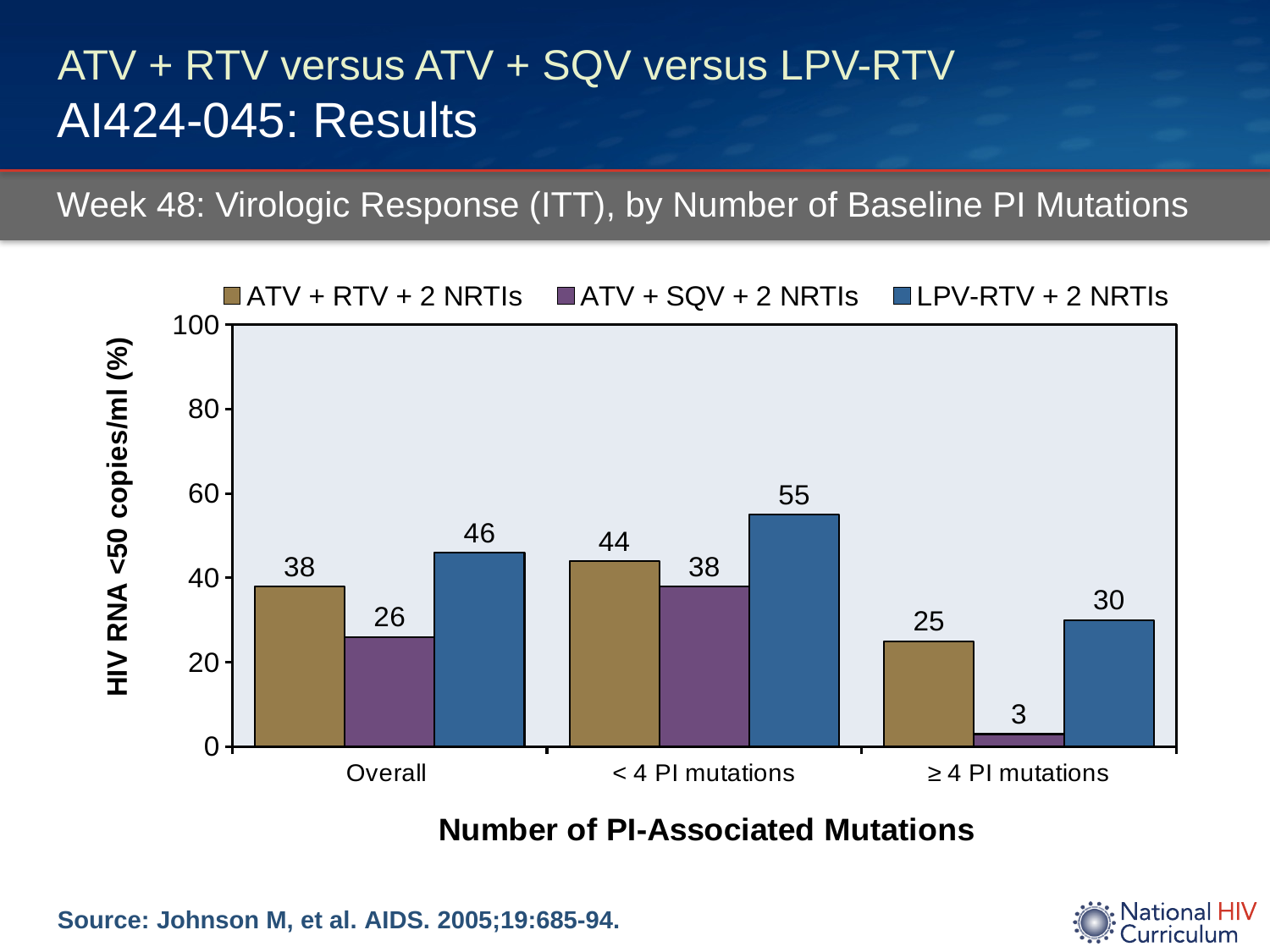
What is the difference between the LPV-RTV + 2 NRTIs and ATV + SQV + 2 NRTIs values in the Overall category? 20 What is the value for LPV-RTV + 2 NRTIs in the < 4 PI mutations category? 55 What is the value for ATV + SQV + 2 NRTIs in the ≥ 4 PI mutations category? 3 Which series has the highest value in the Overall category? LPV-RTV + 2 NRTIs What is the label of the y axis? HIV RNA <50 copies/ml (%) How many categories are shown on the x axis? 3 Which is larger: ATV + RTV + 2 NRTIs in the < 4 PI mutations category or ATV + SQV + 2 NRTIs in the same category? ATV + RTV + 2 NRTIs What is the difference between the ATV + RTV + 2 NRTIs and LPV-RTV + 2 NRTIs values in the ≥ 4 PI mutations category? 5 How many series does the legend list? 3 What kind of chart is shown on the slide? Bar chart What is the value for ATV + RTV + 2 NRTIs in the Overall category? 38 Which series has the lowest value in the ≥ 4 PI mutations category? ATV + SQV + 2 NRTIs